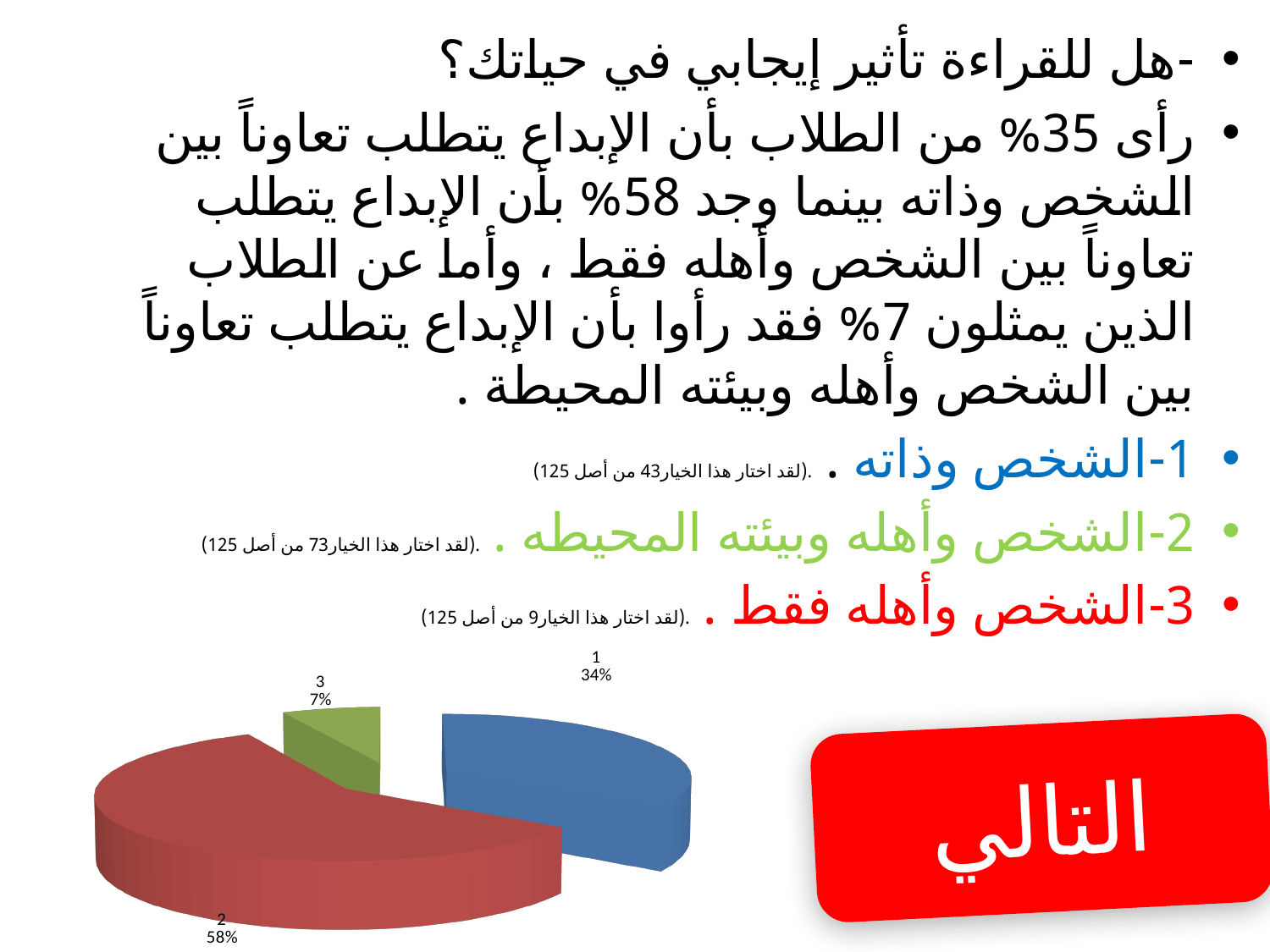
How many slices does the pie chart have? 3 What kind of chart is shown at the bottom of the slide? pie chart What percentage is shown for slice 3 in the pie chart? 7% What colour is the largest slice (slice 2) in the pie chart? red What is the difference in percentage points between slice 1 and slice 3 in the pie chart? 27 What colour is slice 3 in the pie chart? green What percentage is shown for slice 1 in the pie chart? 34% What is the difference in percentage points between slice 2 and slice 1 in the pie chart? 24 What percentage is shown for slice 2 in the pie chart? 58% In the pie chart, which slice is larger, slice 1 or slice 3? 1 Which slice of the pie chart is the smallest? 3 Which slice of the pie chart is the largest? 2